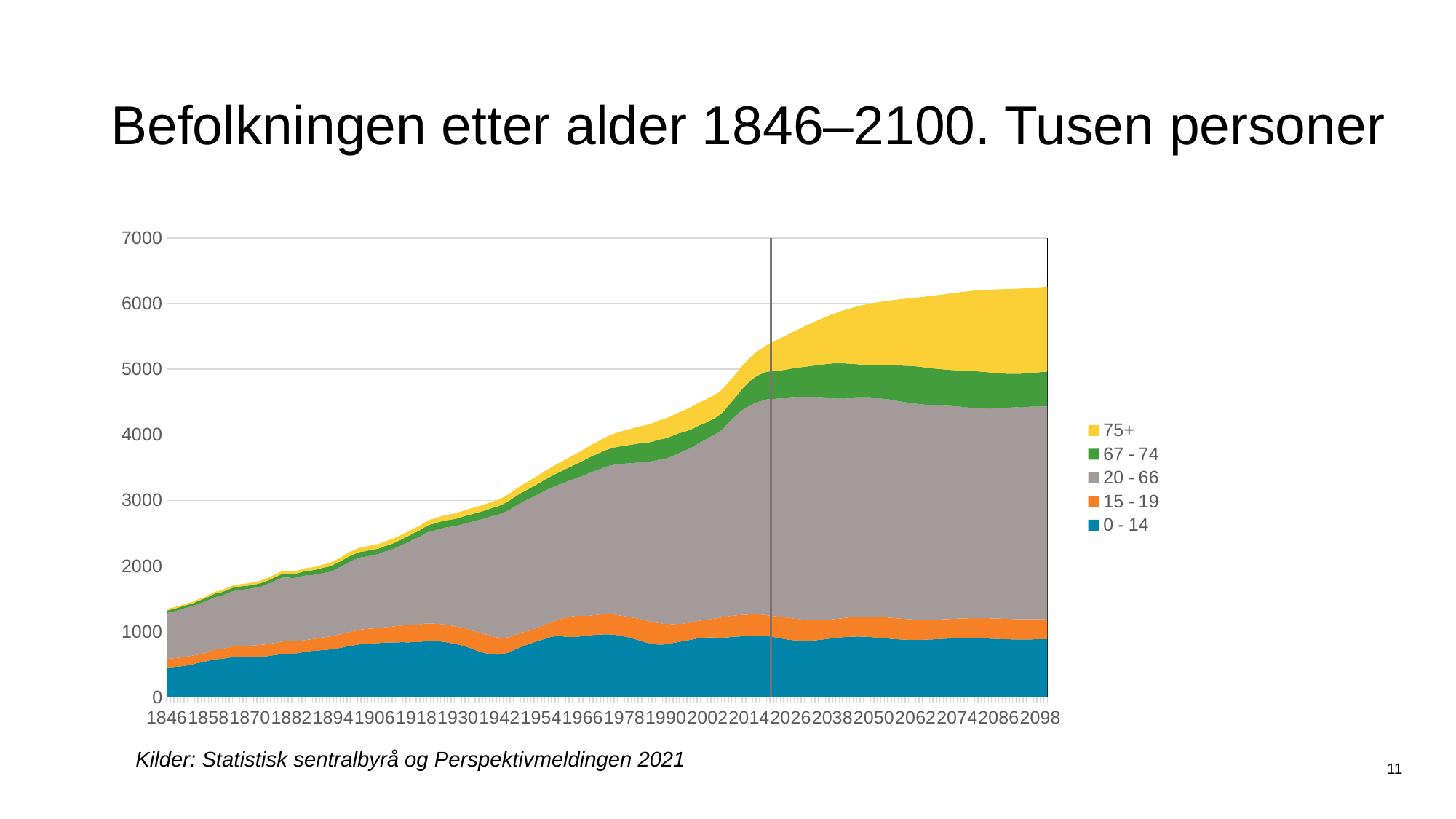
How many year labels are shown on the x axis? 22 Is the total population in 1846 greater or less than 2000? less How many series does the legend list? 5 Which age group is shown in yellow in the legend? 75+ What kind of chart is shown on the slide? Stacked area chart Is the total population in 1990 greater or less than 5000? less Is the total population in 1942 greater or less than 4000? less Which age group makes up the largest part of the population across the chart? 20 - 66 What is the title of the chart? Befolkningen etter alder 1846–2100. Tusen personer Does the total population rise or fall from 1846 to 2098? Rises